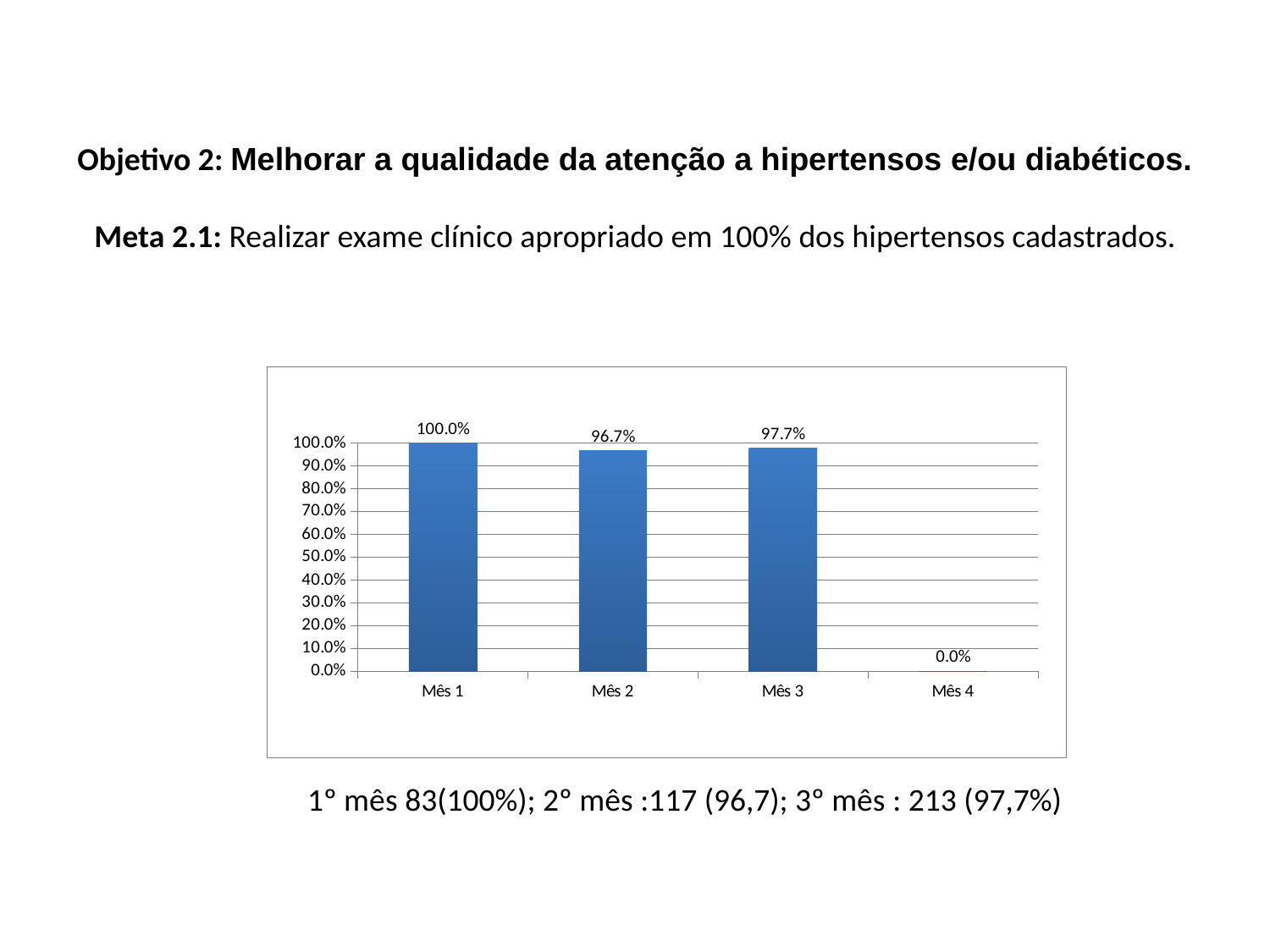
What is the value for Mês 4? 0.0% What is the value for Mês 2? 96.7% What is the difference between the values for Mês 1 and Mês 2? 3.3% What is the difference between the values for Mês 3 and Mês 2? 1.0% What is the highest tick value shown on the y axis? 100.0% What is the value for Mês 1? 100.0% Which is larger, the value for Mês 2 or the value for Mês 3? Mês 3 Which month has the highest value? Mês 1 What is the value for Mês 3? 97.7% What kind of chart is shown on the slide? Bar chart How many categories are shown on the x axis? 4 Which month has the lowest value? Mês 4